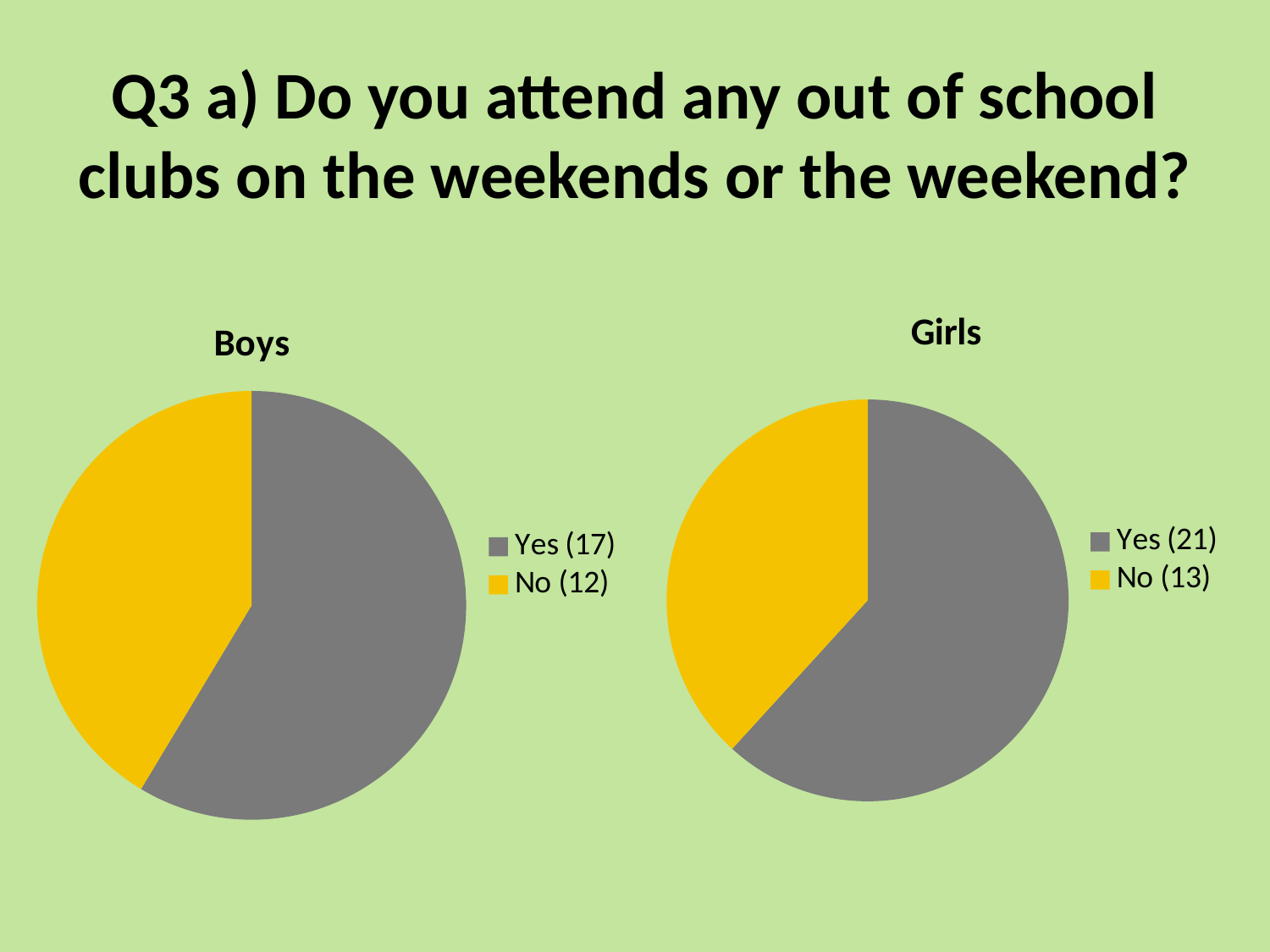
In the Boys chart, how many boys answered No? 12 In the Girls chart, what is the difference between the number of Yes and No responses? 8 In the Boys chart, which response has the larger slice? Yes In the Boys chart, how many boys answered Yes? 17 Which is larger: the number of boys who answered Yes or the number of girls who answered Yes? Girls who answered Yes In the Girls chart, what is the total number of responses? 34 In the Girls chart, how many girls answered No? 13 In the Boys chart, what colour is the No slice? Yellow In the Girls chart, which response has the smaller slice? No In the Boys chart, what is the difference between the number of Yes and No responses? 5 What type of charts are shown on the slide? Pie charts In the Girls chart, how many girls answered Yes? 21